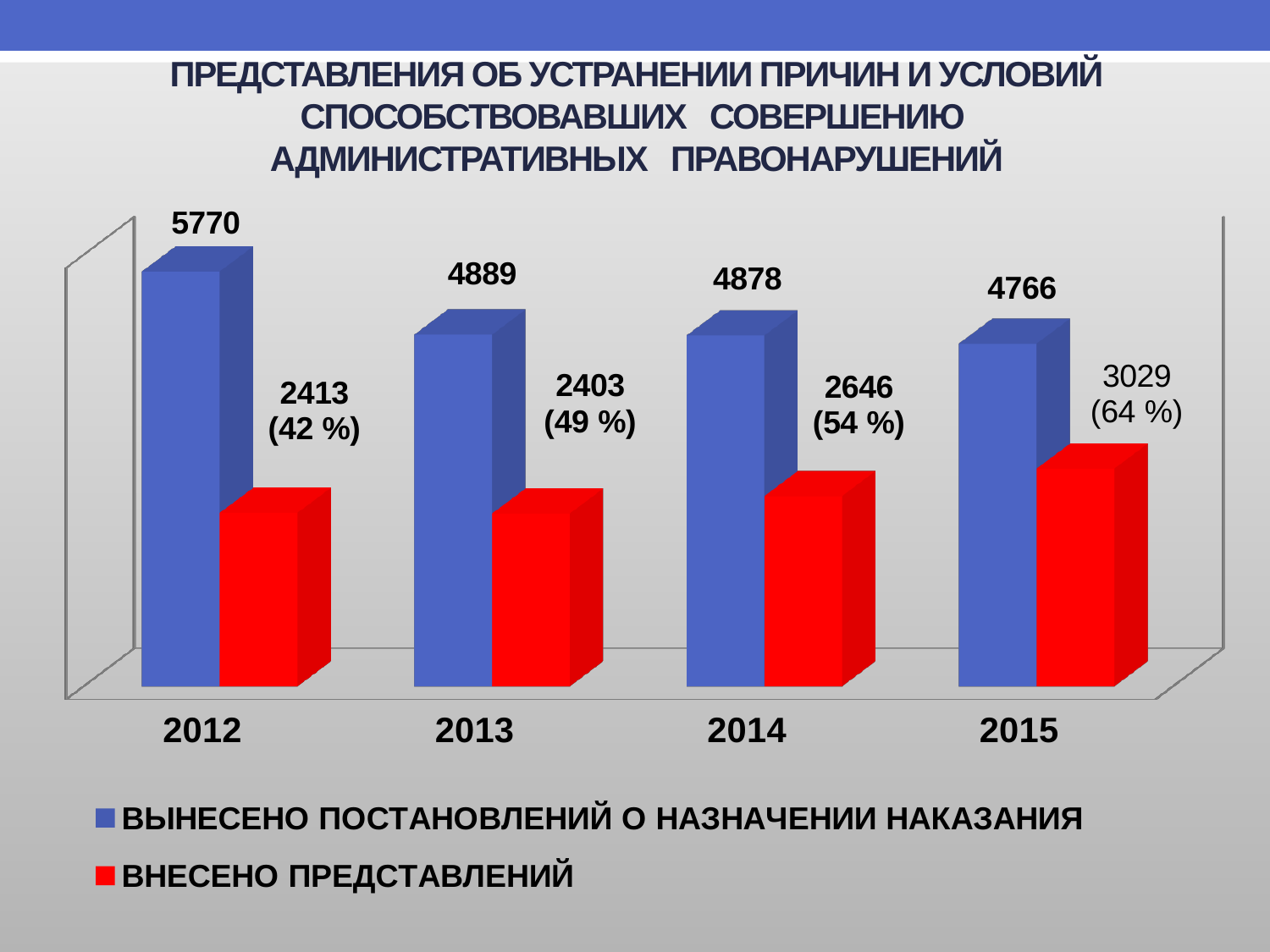
What kind of chart is shown on the slide? Bar chart How many series does the legend list? 2 What is the value of ВНЕСЕНО ПРЕДСТАВЛЕНИЙ for 2014? 2646 What percentage is shown next to the ВНЕСЕНО ПРЕДСТАВЛЕНИЙ value for 2015? 64 % What is the value of ВЫНЕСЕНО ПОСТАНОВЛЕНИЙ О НАЗНАЧЕНИИ НАКАЗАНИЯ for 2012? 5770 Which is larger: ВНЕСЕНО ПРЕДСТАВЛЕНИЙ in 2013 or in 2015? 2015 In which year is ВЫНЕСЕНО ПОСТАНОВЛЕНИЙ О НАЗНАЧЕНИИ НАКАЗАНИЯ highest? 2012 How many years are shown on the x axis? 4 What colour are the bars for ВНЕСЕНО ПРЕДСТАВЛЕНИЙ? Red Does ВЫНЕСЕНО ПОСТАНОВЛЕНИЙ О НАЗНАЧЕНИИ НАКАЗАНИЯ rise or fall from 2012 to 2015? Fall In which year is ВНЕСЕНО ПРЕДСТАВЛЕНИЙ lowest? 2013 What is the difference between ВЫНЕСЕНО ПОСТАНОВЛЕНИЙ О НАЗНАЧЕНИИ НАКАЗАНИЯ in 2012 and 2015? 1004